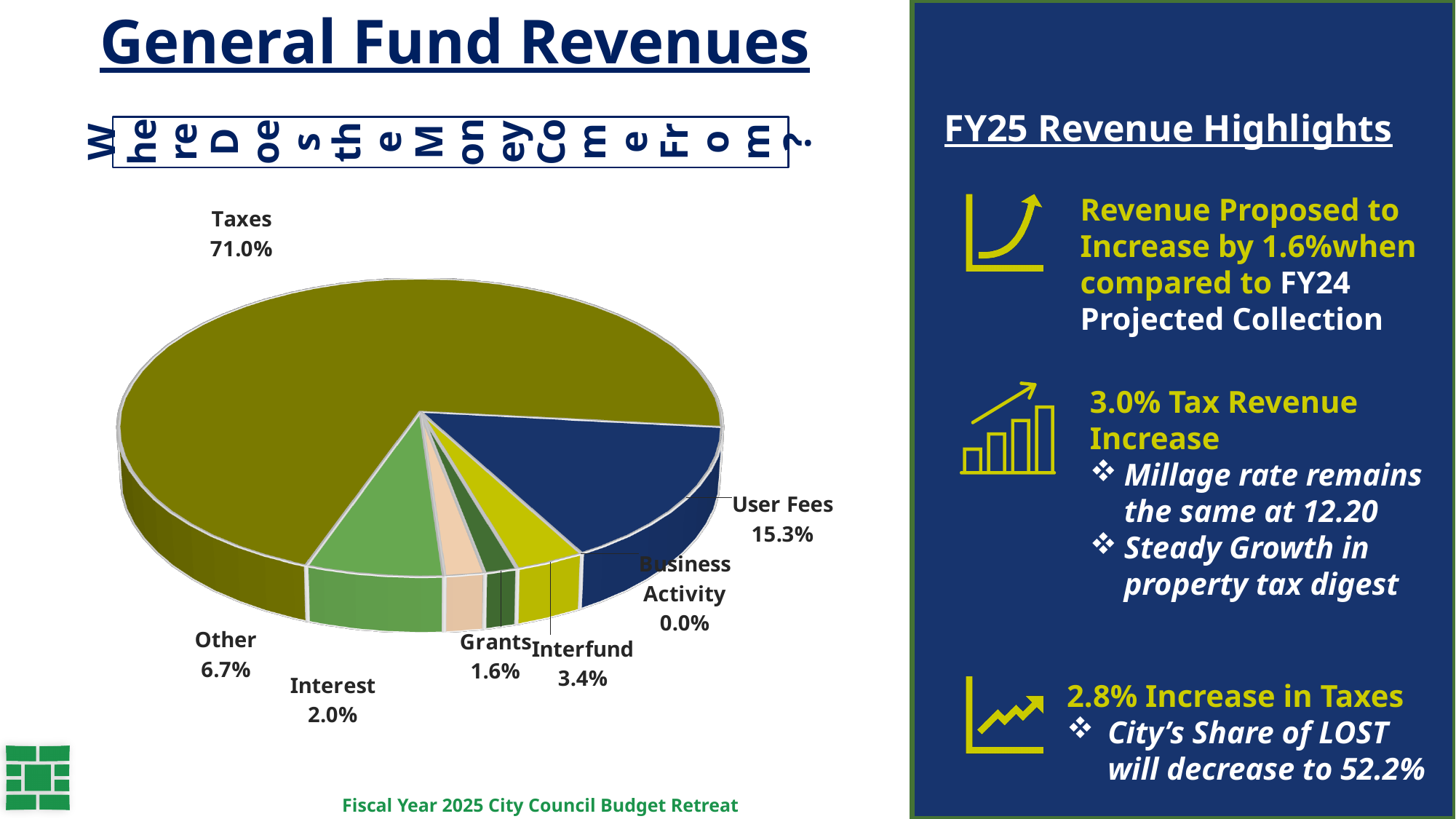
What percentage is shown for Business Activity in the pie chart? 0.0% How many categories are shown in the pie chart? 7 What percentage is shown for Interfund in the pie chart? 3.4% What share of General Fund Revenues comes from Taxes? 71.0% What percentage is shown for Grants in the pie chart? 1.6% Which is larger, the share for Interfund or the share for Interest? Interfund What kind of chart is shown on the slide? pie chart Which category has the smallest share in the pie chart? Business Activity Which category has the largest slice of the pie chart? Taxes What share of General Fund Revenues comes from User Fees? 15.3% What is the difference in percentage points between Other and Interest? 4.7